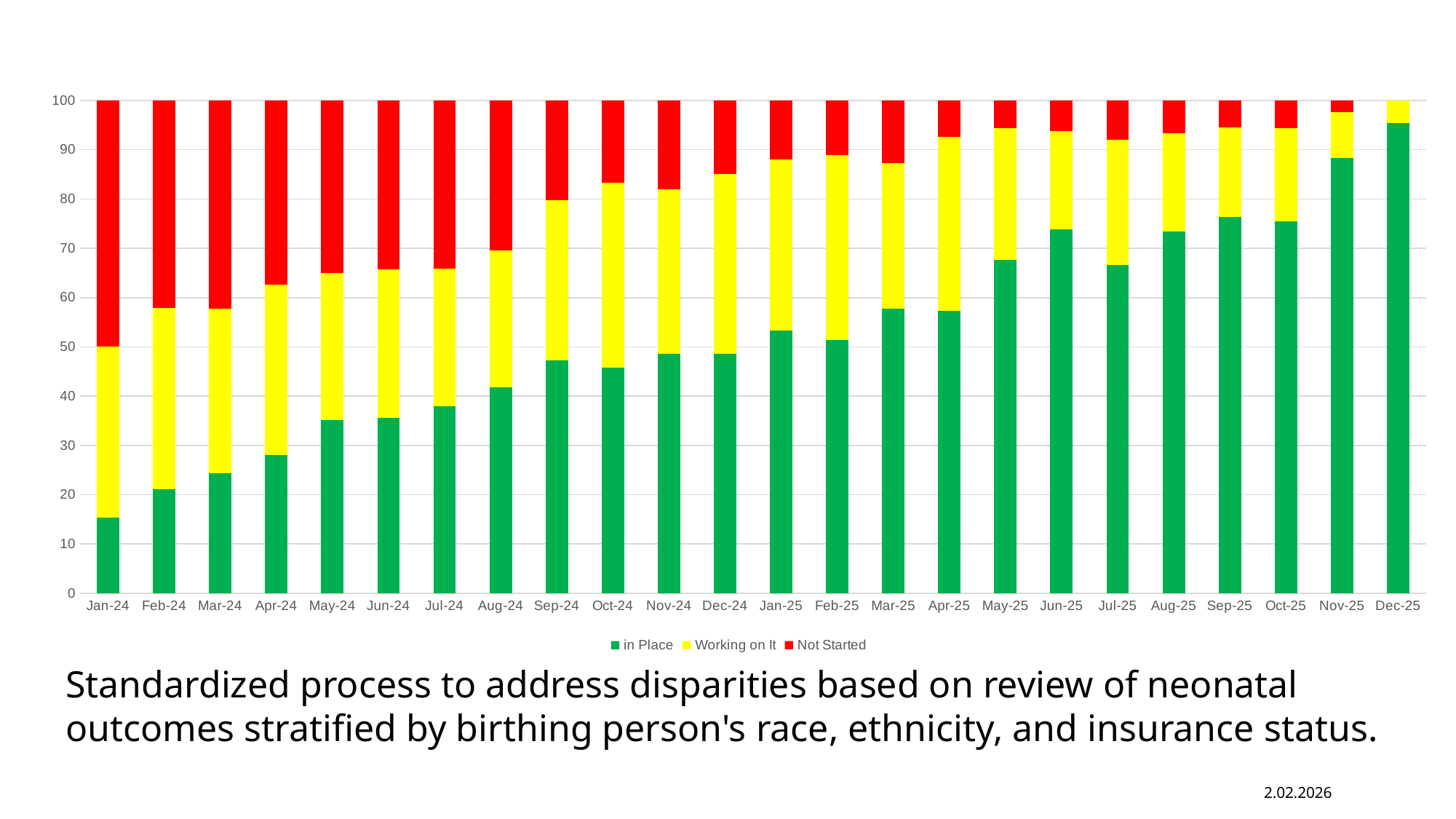
Which colour represents the 'Not Started' series? Red Which month has the larger 'in Place' value, Jun-25 or Jul-25? Jun-25 Is the 'in Place' value for Dec-25 greater or less than 90? greater What kind of chart is shown on the slide? Stacked bar chart Which month has the highest 'in Place' value? Dec-25 What are the three series named in the legend? in Place, Working on It, Not Started Is the 'in Place' value for Jan-24 greater or less than 20? less Which month has the largest 'Not Started' segment? Jan-24 How many series does the legend list? 3 Does the 'in Place' share rise or fall from Jan-24 to Dec-25? Rise Which month has the lowest 'in Place' value? Jan-24 How many months are shown along the x axis? 24